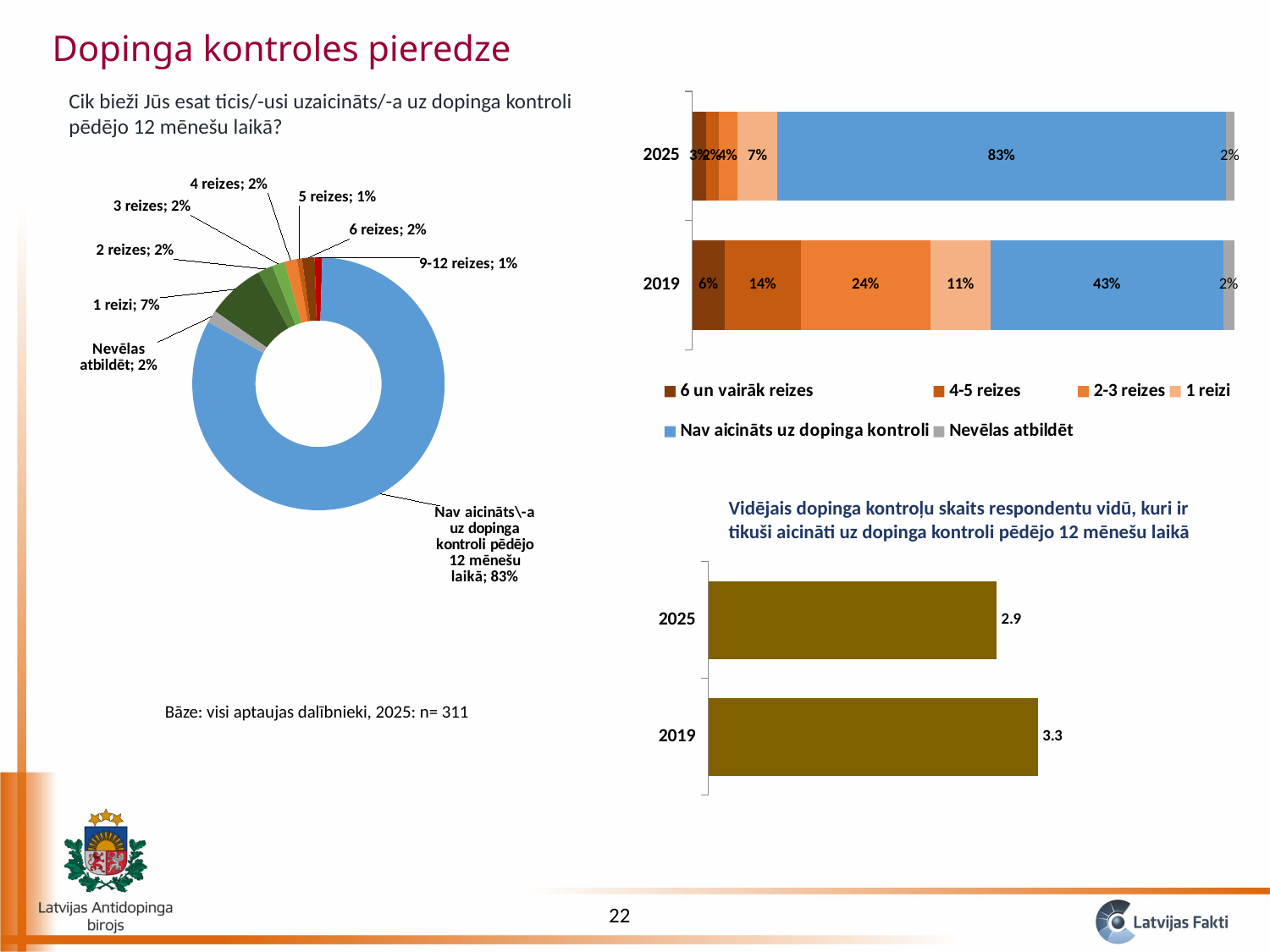
In the donut chart on the left, which category has the largest share? Nav aicināts/-a uz dopinga kontroli pēdējo 12 mēnešu laikā In the donut chart on the left, what percentage of respondents were invited to doping control once (1 reizi)? 7% In the stacked bar chart at the top right, how many series does the legend list? 6 In the stacked bar chart at the top right, what is the value for '1 reizi' in 2025? 7% In the stacked bar chart at the top right, what is the value for 'Nav aicināts uz dopinga kontroli' in 2019? 43% What kind of chart is the one titled 'Vidējais dopinga kontroļu skaits respondentu vidū...'? Bar chart In the chart titled 'Vidējais dopinga kontroļu skaits respondentu vidū...', which year has the higher value, 2019 or 2025? 2019 In the donut chart on the left, how many categories are labelled? 9 In the stacked bar chart at the top right, what is the difference between the 'Nav aicināts uz dopinga kontroli' values for 2025 and 2019? 40 percentage points In the chart titled 'Vidējais dopinga kontroļu skaits respondentu vidū...', what is the value for 2025? 2.9 In the donut chart on the left, what share of respondents were not invited to doping control in the last 12 months (Nav aicināts/-a uz dopinga kontroli pēdējo 12 mēnešu laikā)? 83% In the stacked bar chart at the top right, what is the value for '2-3 reizes' in 2019? 24%